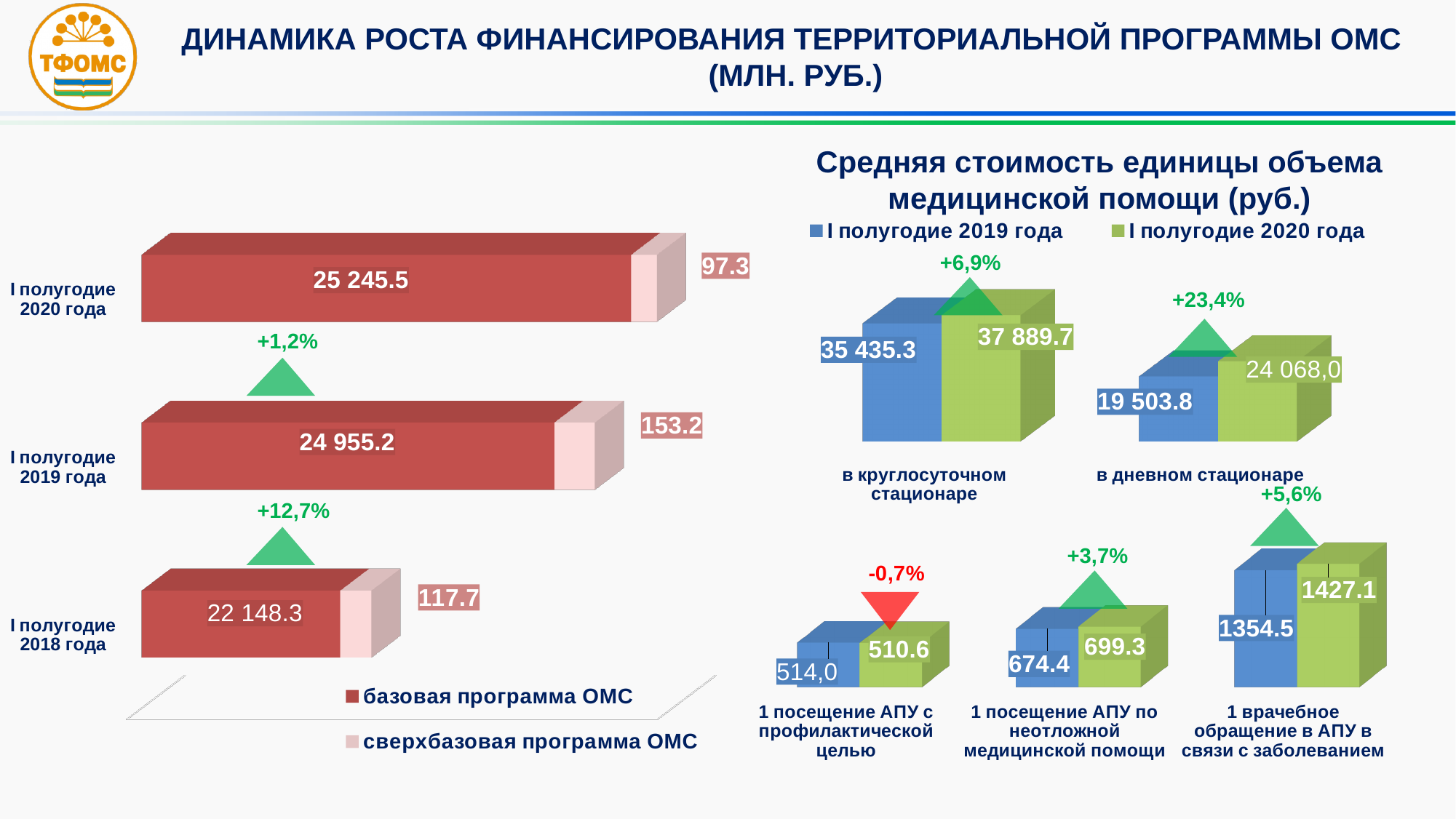
In the left chart on funding dynamics, what kind of chart is it? Bar chart In the chart 'Средняя стоимость единицы объема медицинской помощи (руб.)', what is the value for 1 посещение АПУ с профилактической целью in I полугодие 2019 года? 514,0 In the chart 'Средняя стоимость единицы объема медицинской помощи (руб.)', what is the difference between I полугодие 2020 года and I полугодие 2019 года for в круглосуточном стационаре? 2 454.4 In the chart 'Средняя стоимость единицы объема медицинской помощи (руб.)', which is larger for 1 врачебное обращение в АПУ в связи с заболеванием: I полугодие 2019 года or I полугодие 2020 года? I полугодие 2020 года In the left chart on funding dynamics, which period has the lowest value for the базовая программа ОМС? I полугодие 2018 года In the left chart on funding dynamics, what is the total of the stacked bar for I полугодие 2019 года? 25 108.4 In the left chart on funding dynamics, what is the value of the базовая программа ОМС for I полугодие 2020 года? 25 245.5 In the chart 'Средняя стоимость единицы объема медицинской помощи (руб.)', which category has the highest value in I полугодие 2020 года? в круглосуточном стационаре In the left chart on funding dynamics, how many series does the legend list? 2 In the chart 'Средняя стоимость единицы объема медицинской помощи (руб.)', how many categories are shown? 5 In the chart 'Средняя стоимость единицы объема медицинской помощи (руб.)', what is the value for в дневном стационаре in I полугодие 2020 года? 24 068,0 In the left chart on funding dynamics, what is the value of the сверхбазовая программа ОМС for I полугодие 2019 года? 153.2